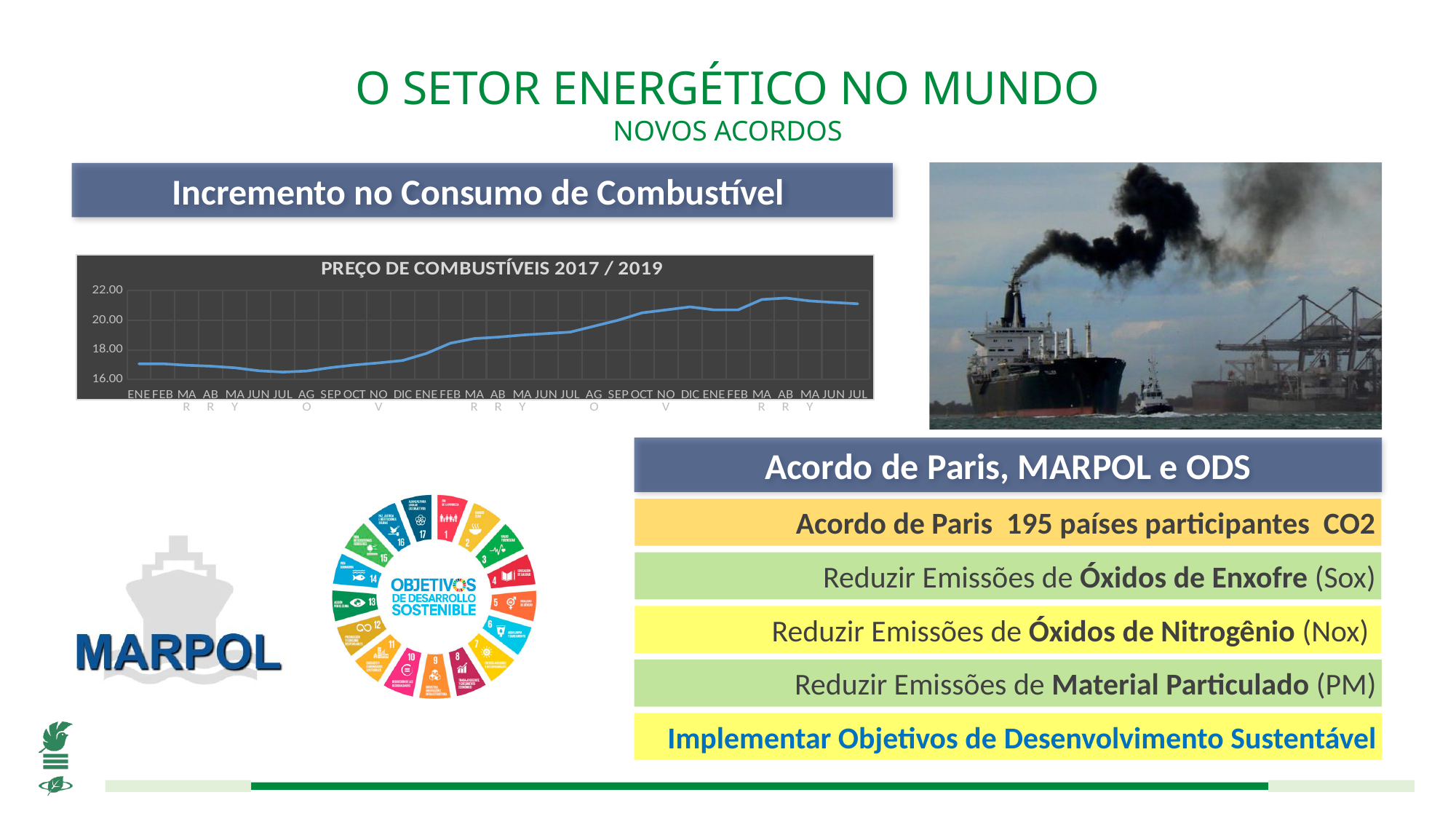
What kind of chart is shown under the heading 'Incremento no Consumo de Combustível'? line chart In the 'PREÇO DE COMBUSTÍVEIS 2017 / 2019' chart, is the value for the second OCT greater or less than 20.00? greater What is the title of the chart on the slide? PREÇO DE COMBUSTÍVEIS 2017 / 2019 In the 'PREÇO DE COMBUSTÍVEIS 2017 / 2019' chart, which is larger: the value for the first ENE or the value for the third ENE? the third ENE In the 'PREÇO DE COMBUSTÍVEIS 2017 / 2019' chart, is the value for the first JUN greater or less than 18.00? less In the 'PREÇO DE COMBUSTÍVEIS 2017 / 2019' chart, is the value for the first ENE greater or less than 18.00? less In the 'PREÇO DE COMBUSTÍVEIS 2017 / 2019' chart, which is larger: the value for the first ENE or the value for the last JUL? the last JUL In the 'PREÇO DE COMBUSTÍVEIS 2017 / 2019' chart, do the values generally rise or fall from left to right along the x axis? rise What is the highest tick value shown on the y axis of the 'PREÇO DE COMBUSTÍVEIS 2017 / 2019' chart? 22.00 How many monthly points are plotted in the 'PREÇO DE COMBUSTÍVEIS 2017 / 2019' chart? 31